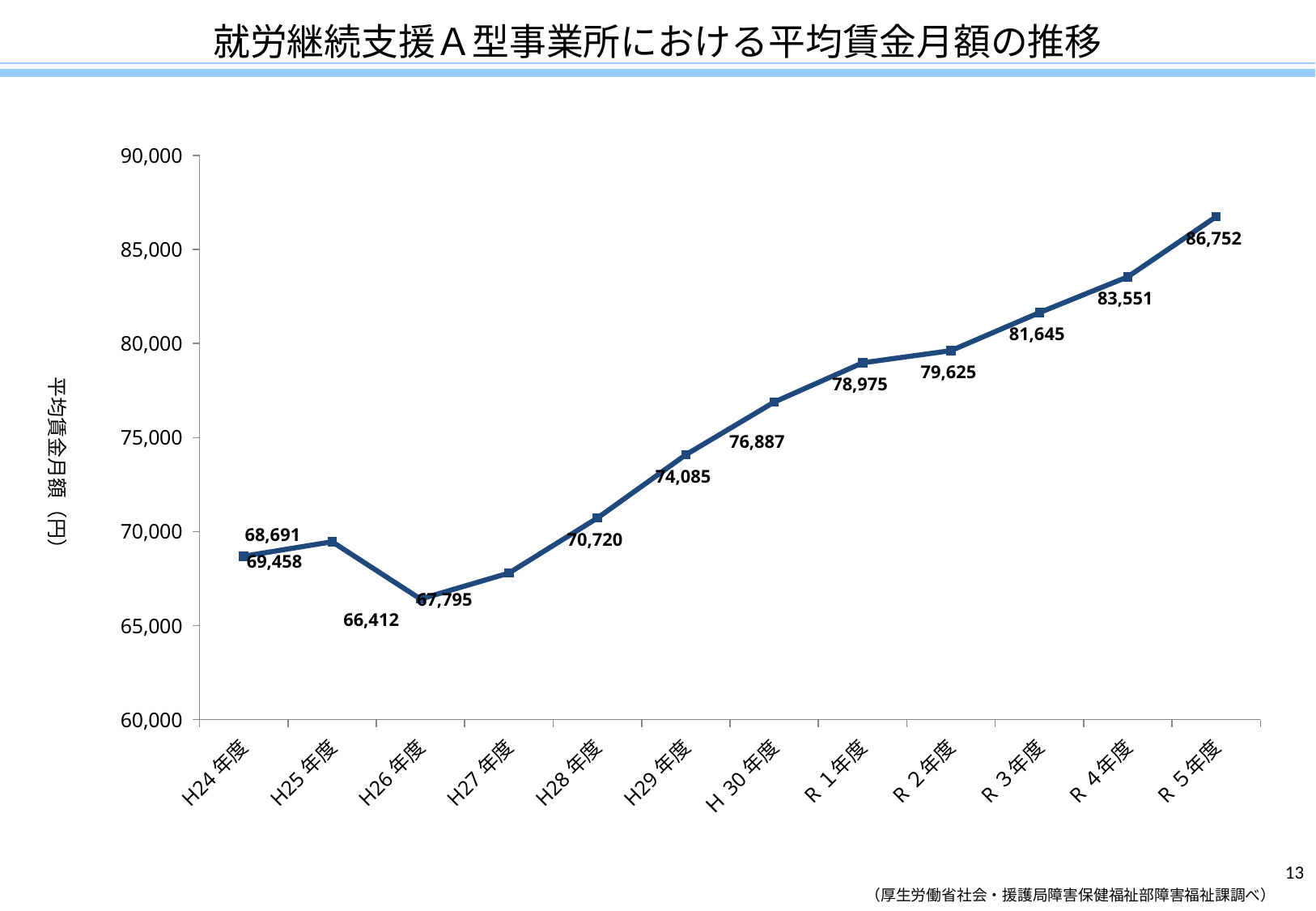
What is the average monthly wage for R 5年度? 86,752 What is the difference between the values for H29年度 and H28年度? 3,365 Which fiscal year has the highest average monthly wage? R 5年度 What is the overall trend of the average monthly wage from H26年度 to R 5年度? rising What is the average monthly wage for R 1年度? 78,975 What type of chart is shown on the slide? line chart What is the average monthly wage for H28年度? 70,720 Which fiscal year has the lowest average monthly wage? H26年度 Which is larger, the value for H25年度 or the value for H27年度? H25年度 What is the average monthly wage for H26年度? 66,412 How many fiscal years are plotted on the x axis? 12 What is the difference between the values for R 5年度 and R 4年度? 3,201